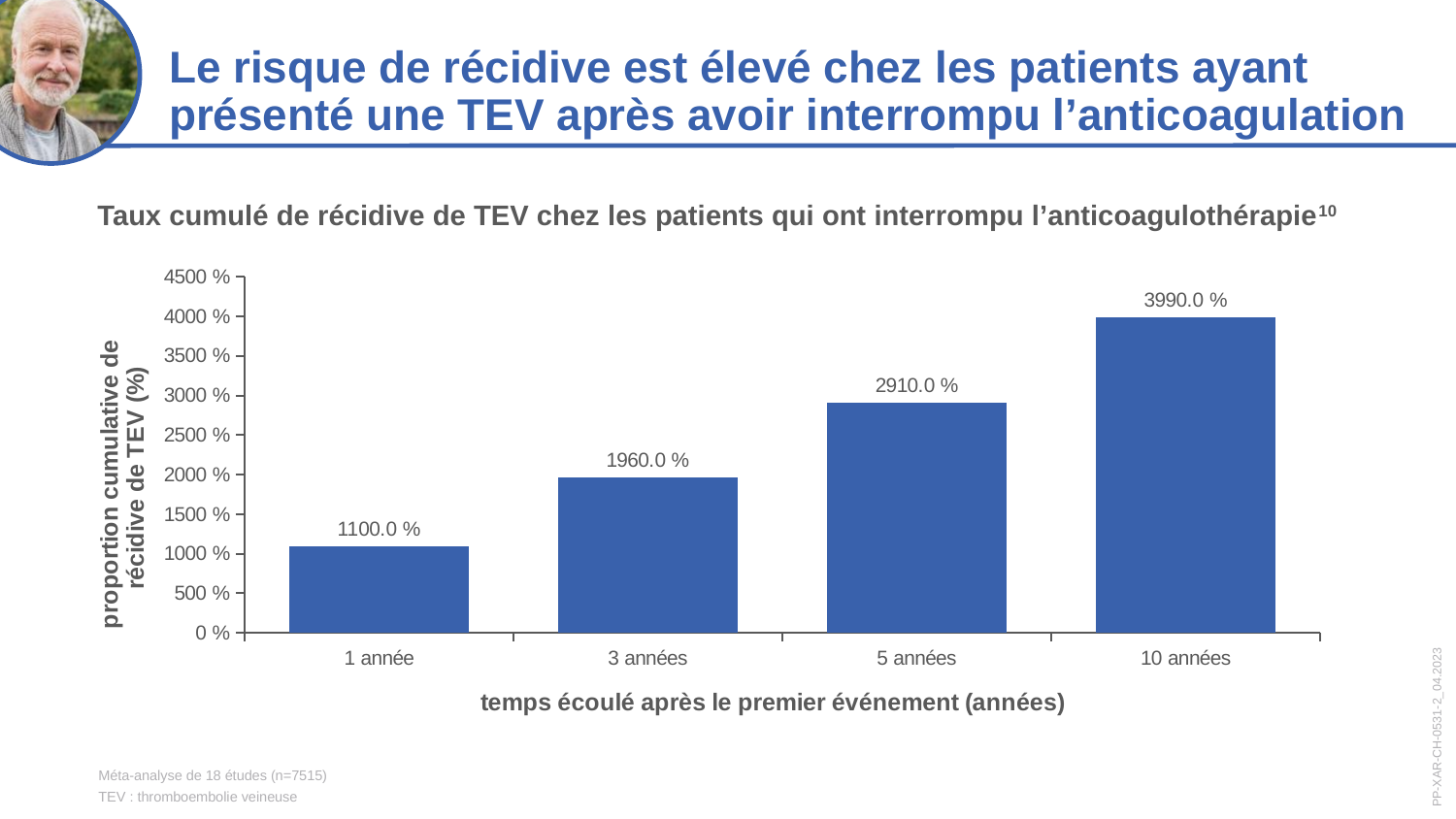
Which category has the highest value? 10 années What is the difference between the values for 5 années and 3 années? 950.0 % Which category has the lowest value? 1 année What is the value for 5 années? 2910.0 % How many categories are shown on the x axis? 4 What is the difference between the values for 10 années and 1 année? 2890.0 % What is the value for 3 années? 1960.0 % Do the values rise or fall as time after the first event increases along the x axis? rise What is the value for 10 années? 3990.0 % What kind of chart is shown on the slide? bar chart What is the value for 1 année? 1100.0 % Which is larger, the value for 3 années or the value for 5 années? 5 années